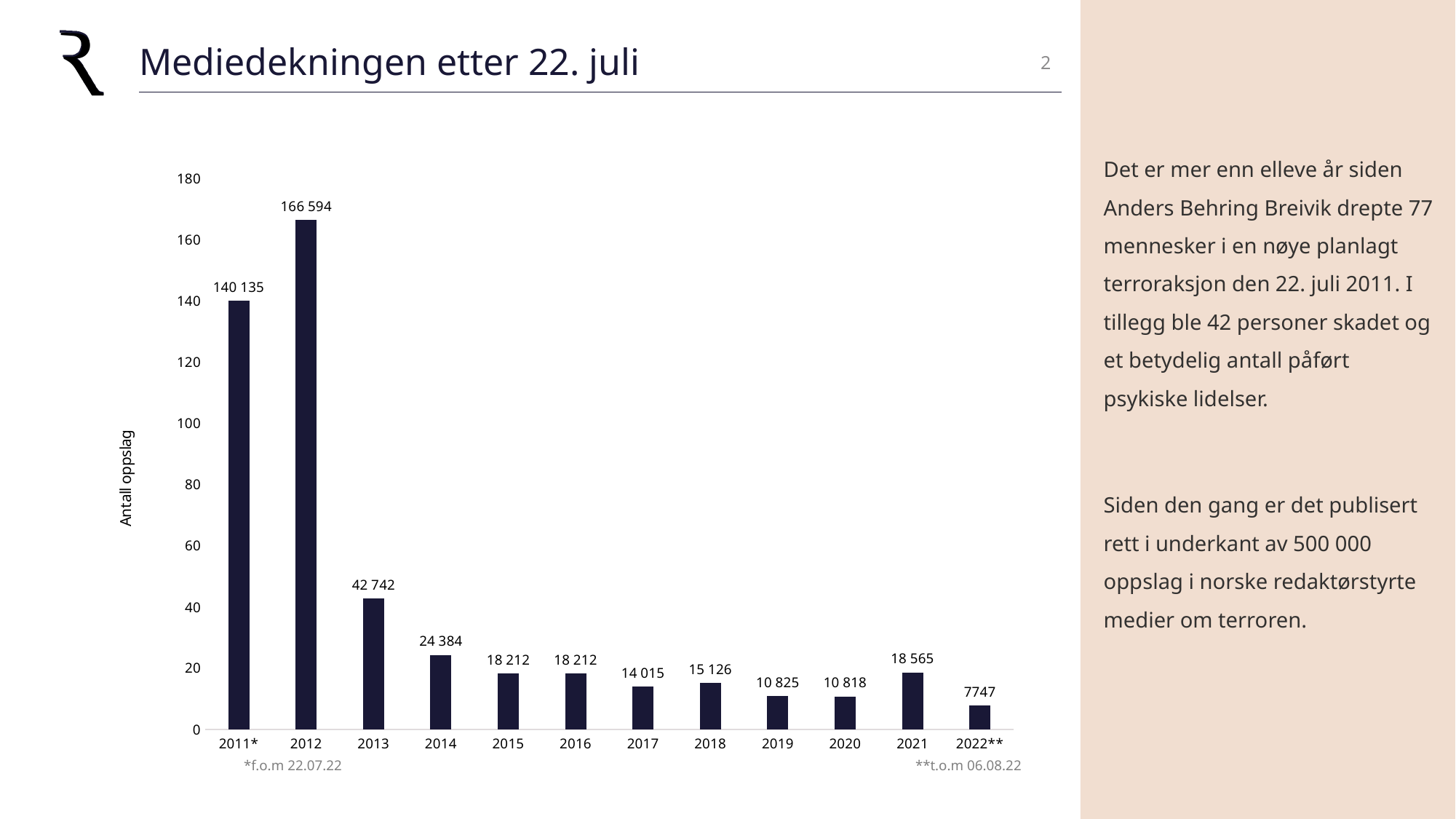
What is the value for 2019? 10 825 What is the value for 2011*? 140 135 How many years are shown on the x axis? 12 Which year has the highest value? 2012 Which is larger, the value for 2017 or the value for 2018? 2018 What is the value for 2022**? 7747 What is the label on the y axis? Antall oppslag What is the value for 2012? 166 594 Which year has the lowest value? 2022** What is the difference between the values for 2012 and 2011*? 26 459 What is the difference between the values for 2013 and 2014? 18 358 What type of chart is shown on the slide? bar chart